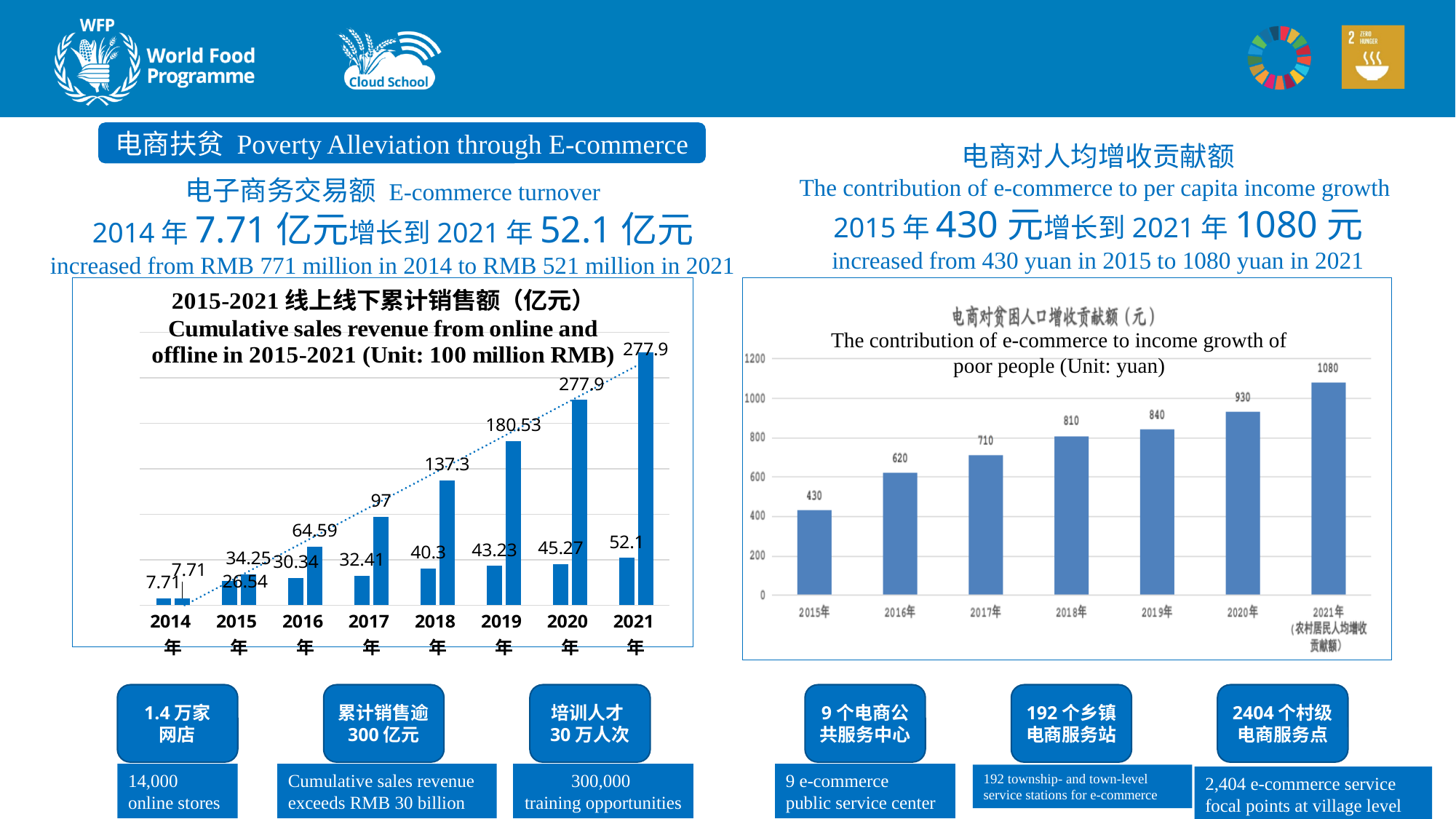
In the chart on the right (contribution of e-commerce to income growth of poor people), which year has the highest value? 2021年 In the chart on the right (contribution of e-commerce to income growth of poor people), do the values rise or fall from 2015年 to 2021年? rise In the chart on the left (Cumulative sales revenue from online and offline in 2015-2021), what is the value of the shorter bar for 2021年? 52.1 In the chart on the right (contribution of e-commerce to income growth of poor people), what is the value for 2018年? 810 In the chart on the right (contribution of e-commerce to income growth of poor people), what is the value for 2016年? 620 In the chart on the right (contribution of e-commerce to income growth of poor people), which year has the lowest value? 2015年 In the chart on the left (Cumulative sales revenue from online and offline in 2015-2021), how many years are shown on the x axis? 8 In the chart on the right (contribution of e-commerce to income growth of poor people), how many years are shown on the x axis? 7 What kind of chart is the chart on the right (contribution of e-commerce to income growth of poor people)? bar chart In the chart on the left (Cumulative sales revenue from online and offline in 2015-2021), what is the value of the taller bar for 2019年? 180.53 In the chart on the right (contribution of e-commerce to income growth of poor people), what is the difference between the 2021年 value and the 2015年 value? 650 In the chart on the left (Cumulative sales revenue from online and offline in 2015-2021), which is larger: the taller bar for 2017年 or the taller bar for 2018年? 2018年